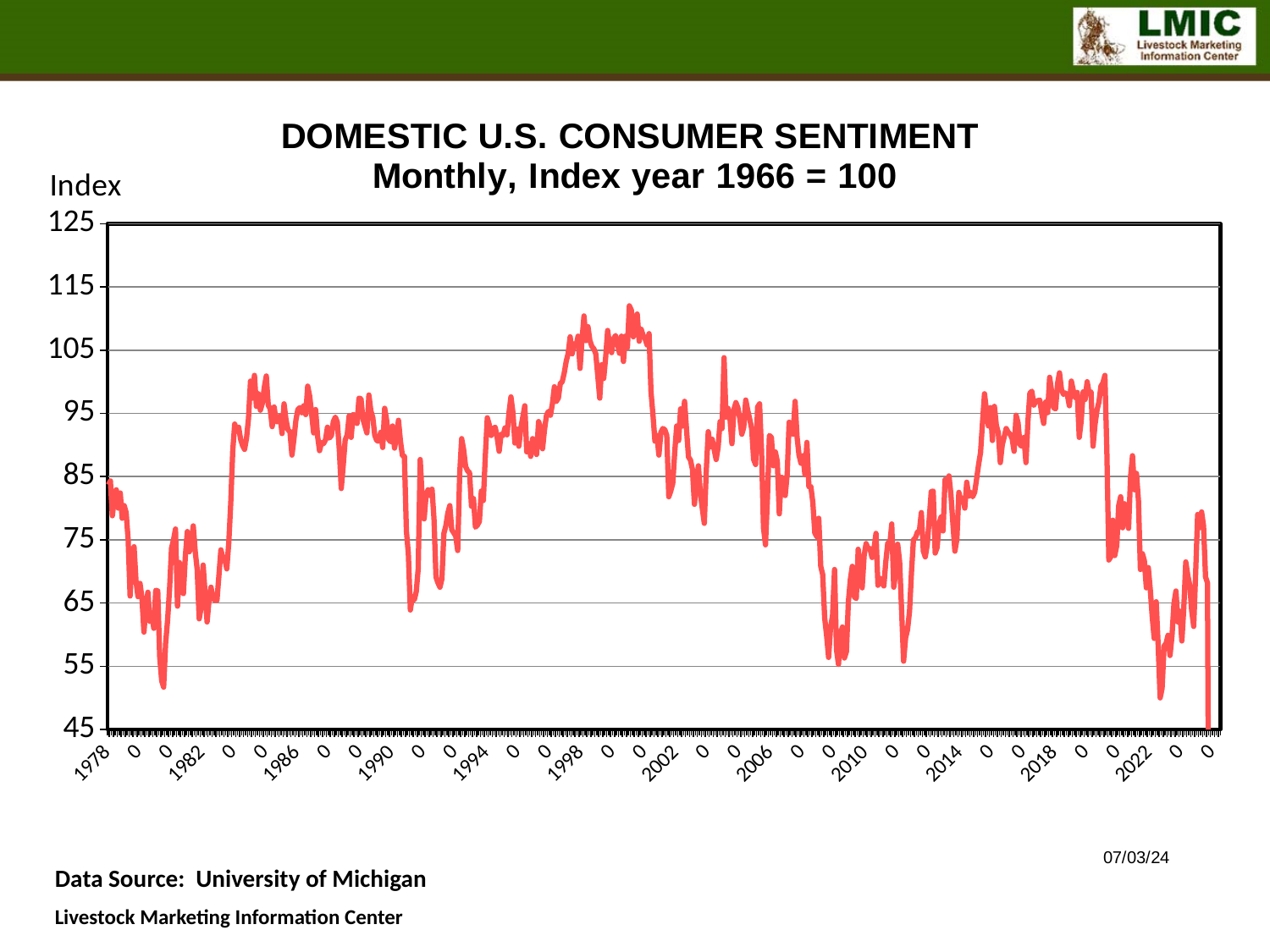
Does the consumer sentiment index generally rise or fall between 1990 and 1998? rise What kind of chart is shown on the slide? line chart What is the title of the chart? DOMESTIC U.S. CONSUMER SENTIMENT Monthly, Index year 1966 = 100 Is the lowest consumer sentiment value around 2022 greater or less than 55? less Does the consumer sentiment index generally rise or fall between 2018 and 2022? fall Is the consumer sentiment index around 1986 greater or less than 85? greater What is the highest value shown on the vertical axis of the chart? 125 Is the consumer sentiment index at the start of the series in 1978 greater or less than 75? greater What is the label on the vertical axis of the chart? Index